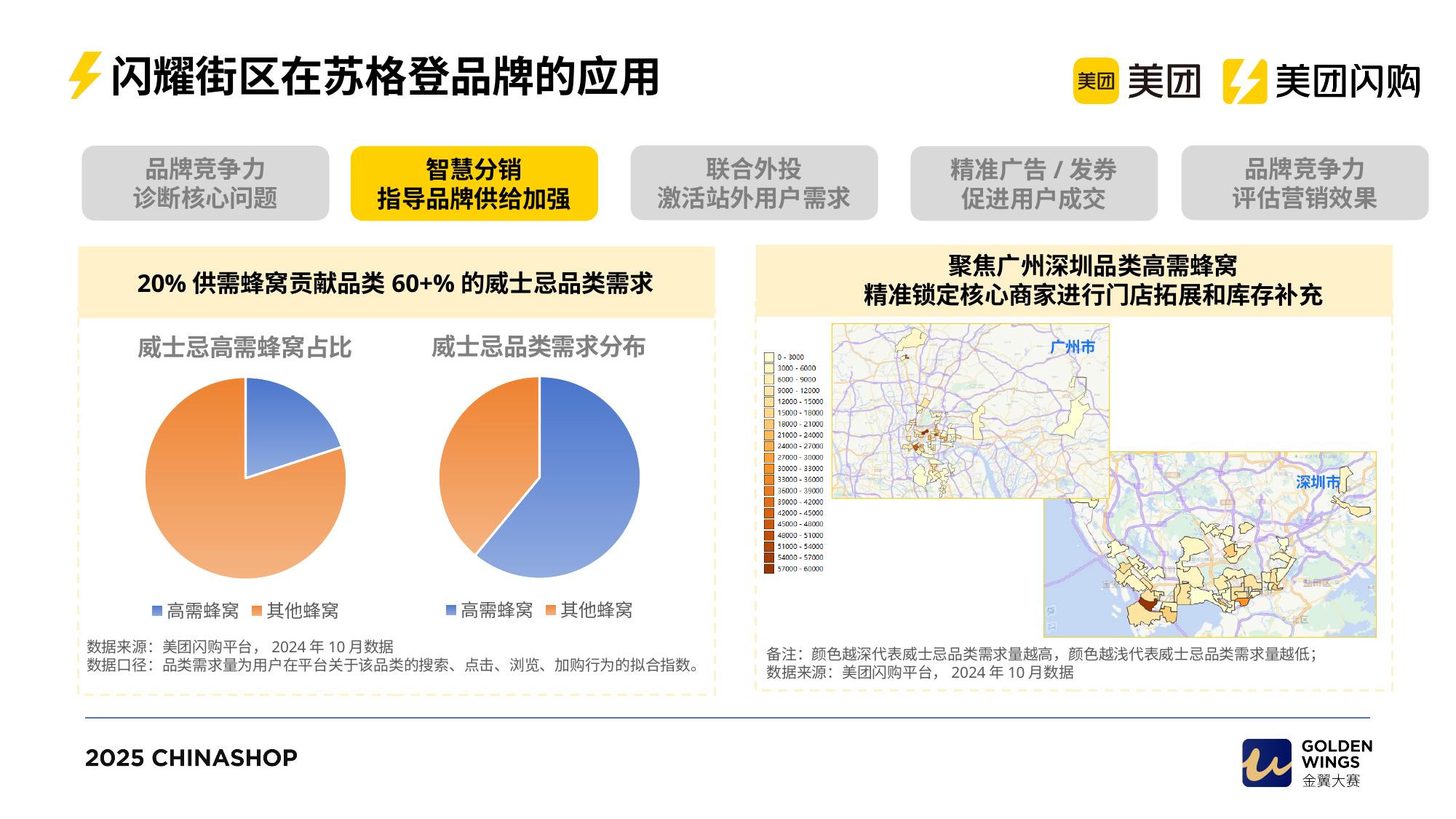
How many entries does the legend of the "威士忌高需蜂窝占比" chart list? 2 In the "威士忌品类需求分布" chart, which slice is the largest? 高需蜂窝 In the "威士忌品类需求分布" chart, which slice is the smallest? 其他蜂窝 In the "威士忌高需蜂窝占比" chart, which slice is the largest? 其他蜂窝 In the "威士忌品类需求分布" chart, which is larger: the 高需蜂窝 slice or the 其他蜂窝 slice? 高需蜂窝 In the "威士忌高需蜂窝占比" chart, what colour is the 高需蜂窝 slice? blue In the "威士忌品类需求分布" chart, how many slices does the pie have? 2 What are the two legend entries of the "威士忌品类需求分布" chart? 高需蜂窝 and 其他蜂窝 What kind of chart is the "威士忌高需蜂窝占比" chart? pie chart What kind of chart is the "威士忌品类需求分布" chart? pie chart In the "威士忌高需蜂窝占比" chart, which slice is the smallest? 高需蜂窝 In the "威士忌高需蜂窝占比" chart, how many slices does the pie have? 2